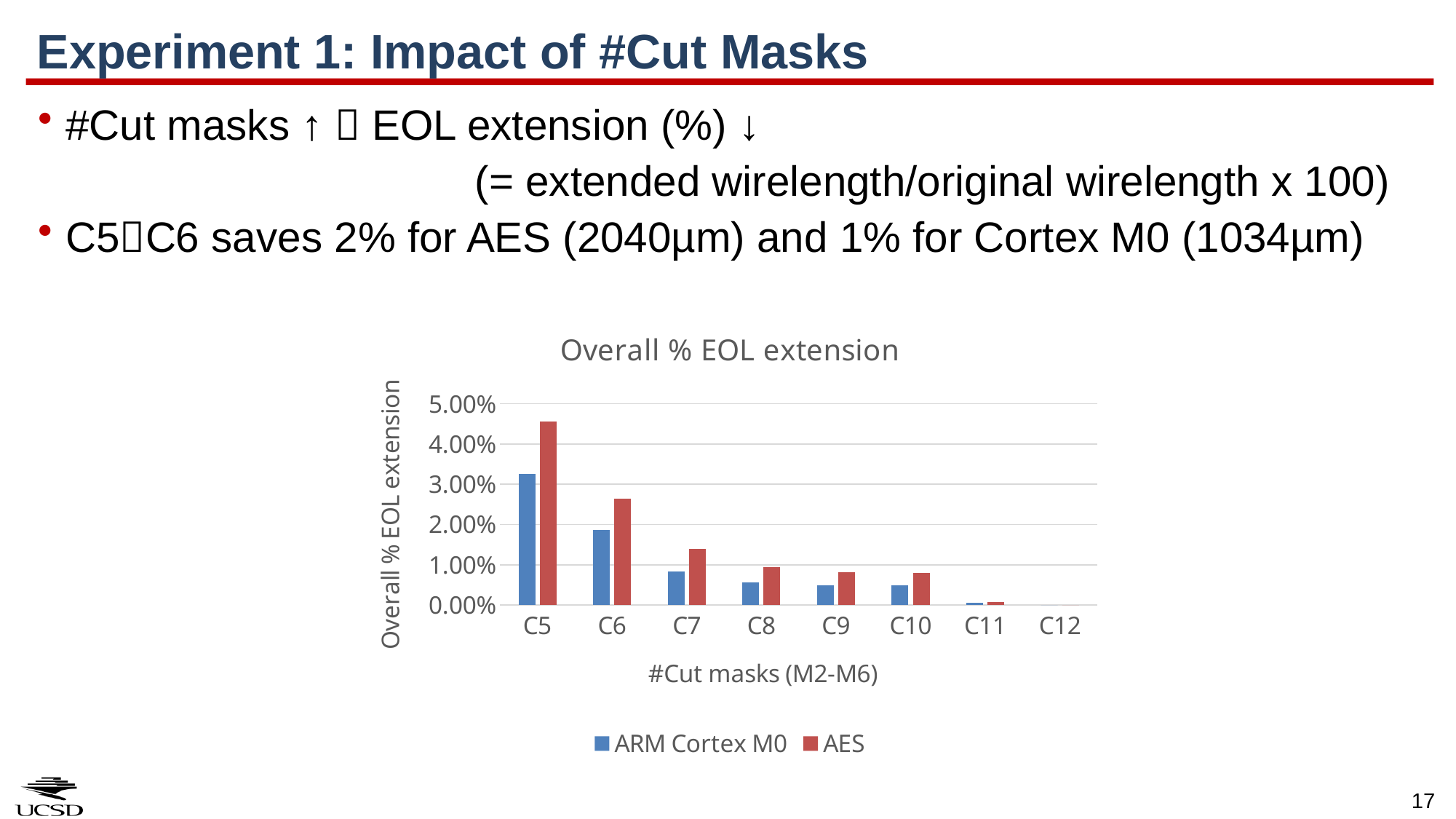
Do the Overall % EOL extension values rise or fall as the number of cut masks increases from C5 to C12? fall Is the ARM Cortex M0 value for C5 greater or less than 3.00%? greater What is the x-axis title of the chart? #Cut masks (M2-M6) What is the title of the chart? Overall % EOL extension How many series does the legend of the chart list? 2 For which #Cut masks category is the ARM Cortex M0 value highest? C5 For which #Cut masks category is the AES value highest? C5 Is the AES value for C6 greater or less than 3.00%? less At C7, which series has the larger value, ARM Cortex M0 or AES? AES Is the AES value for C5 greater or less than 4.00%? greater How many #Cut masks categories are shown on the x axis of the chart? 8 What kind of chart is shown on the slide? bar chart